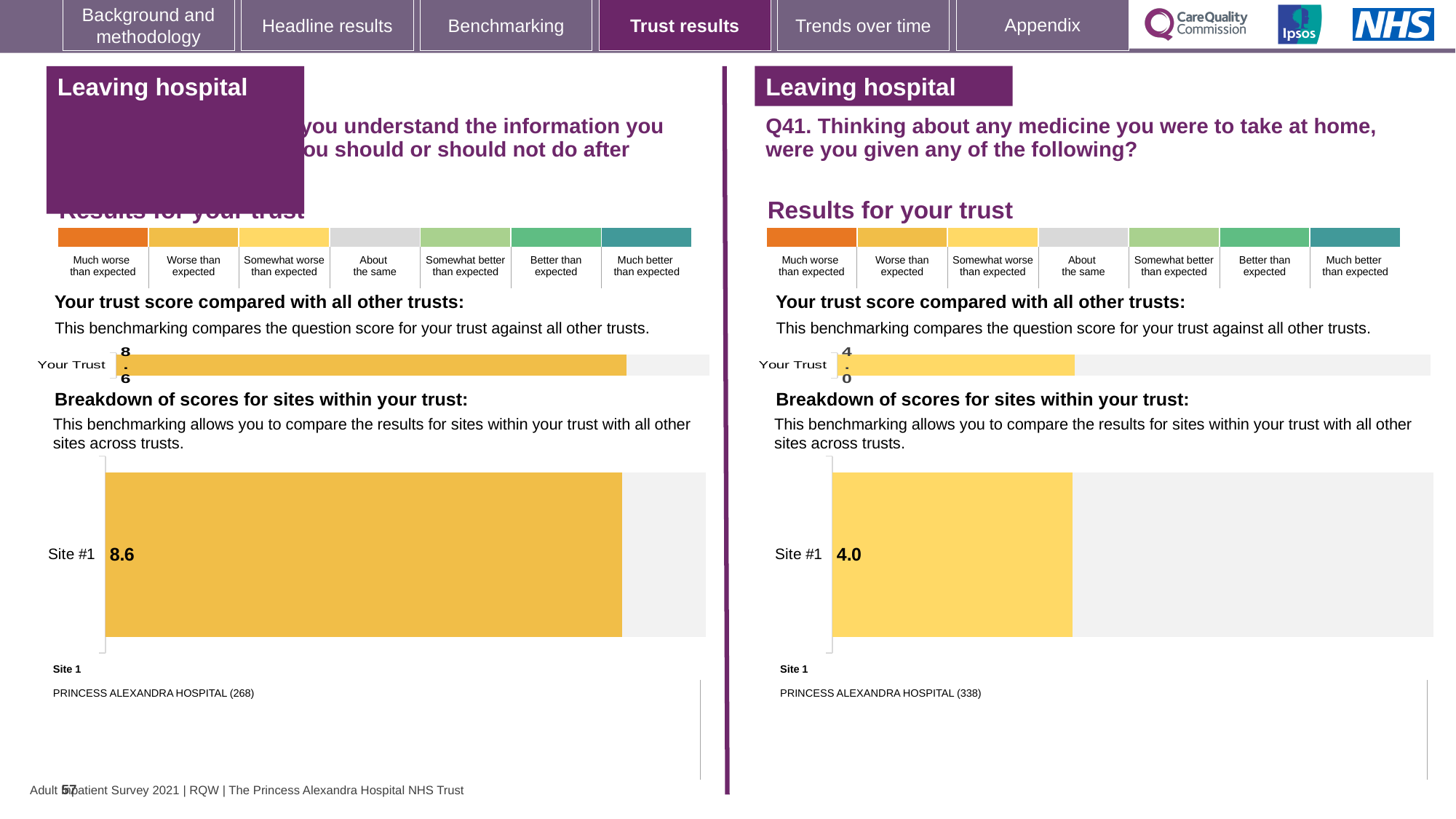
On the left-hand 'Breakdown of scores for sites within your trust' chart, what is the score for Site #1? 8.6 Which hospital is listed as Site 1 on the left-hand side of the slide? PRINCESS ALEXANDRA HOSPITAL (268) On the left-hand 'Your trust score compared with all other trusts' chart, what is the score shown for Your Trust? 8.6 On the right-hand (Q41) 'Breakdown of scores for sites within your trust' chart, what is the score for Site #1? 4.0 On the right-hand (Q41) 'Your trust score compared with all other trusts' chart, what is the score shown for Your Trust? 4.0 What is the difference between the Site #1 score on the left-hand breakdown chart and the Site #1 score on the right-hand (Q41) breakdown chart? 4.6 What kind of chart is used for the 'Breakdown of scores for sites within your trust' on the right-hand (Q41) side? Bar chart Which Site #1 score is larger: the one on the left-hand breakdown chart or the one on the right-hand (Q41) breakdown chart? The left-hand chart (8.6) How many sites are plotted on the left-hand 'Breakdown of scores for sites within your trust' chart? 1 How many sites are plotted on the right-hand (Q41) 'Breakdown of scores for sites within your trust' chart? 1 Which hospital is listed as Site 1 on the right-hand (Q41) side of the slide? PRINCESS ALEXANDRA HOSPITAL (338)